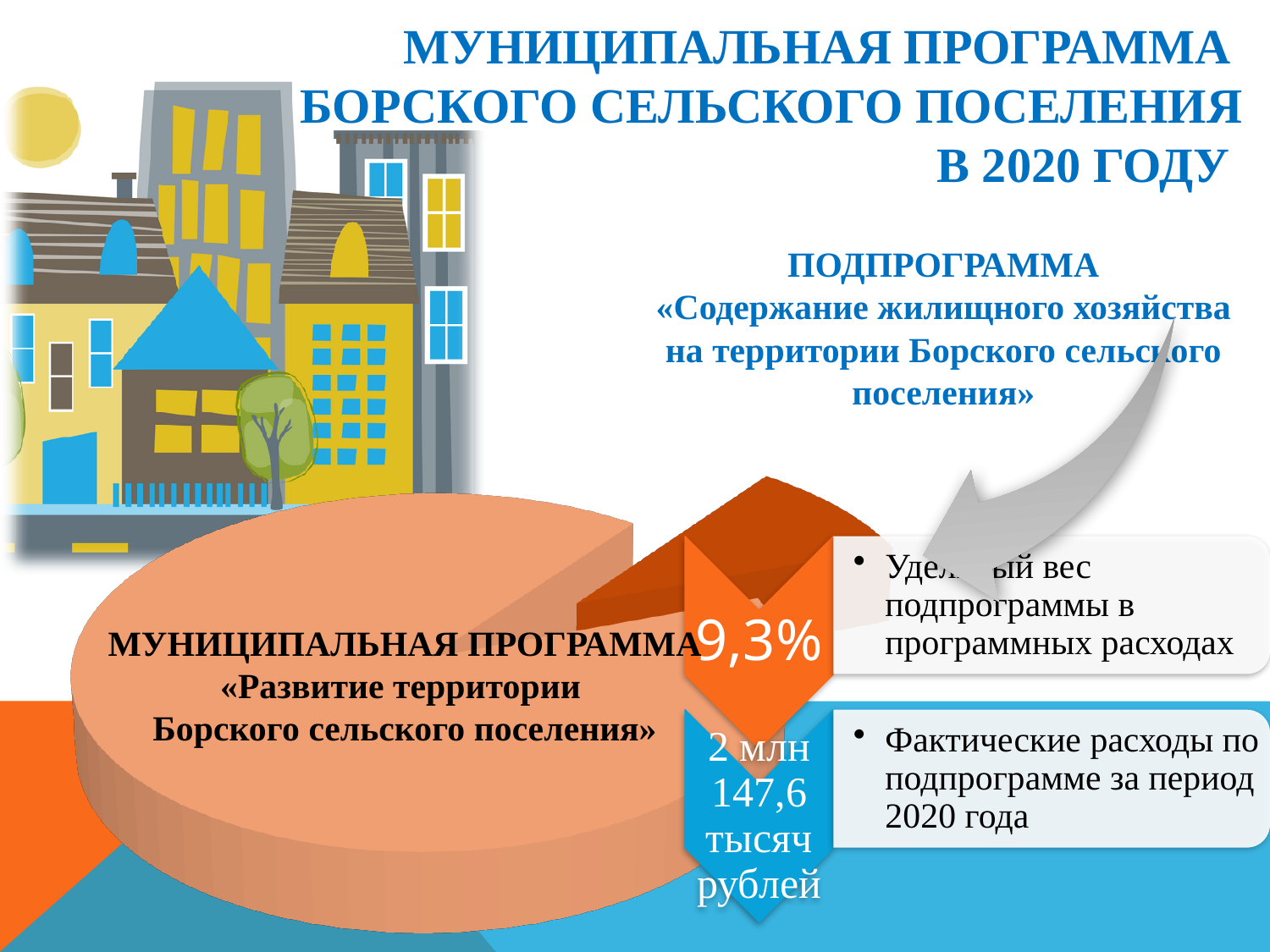
Which slice of the pie chart is the smallest? the subprogram slice (9,3%) How many slices does the pie chart have? 2 What are the actual expenditures on the subprogram for 2020, as printed on the slide? 2 млн 147,6 тысяч рублей What is the удельный вес (share) of the subprogram in the programme expenditures, as printed on the slide? 9,3% Which slice of the pie is larger: the municipal programme «Развитие территории Борского сельского поселения» or the subprogram «Содержание жилищного хозяйства»? МУНИЦИПАЛЬНАЯ ПРОГРАММА «Развитие территории Борского сельского поселения» What label is printed on the large slice of the pie chart? МУНИЦИПАЛЬНАЯ ПРОГРАММА «Развитие территории Борского сельского поселения» What share of the pie does the subprogram «Содержание жилищного хозяйства на территории Борского сельского поселения» represent? 9,3% What colour is the small exploded slice of the pie chart? orange What kind of chart is shown on the slide? pie chart Is the subprogram's share of the pie greater or less than 50%? less